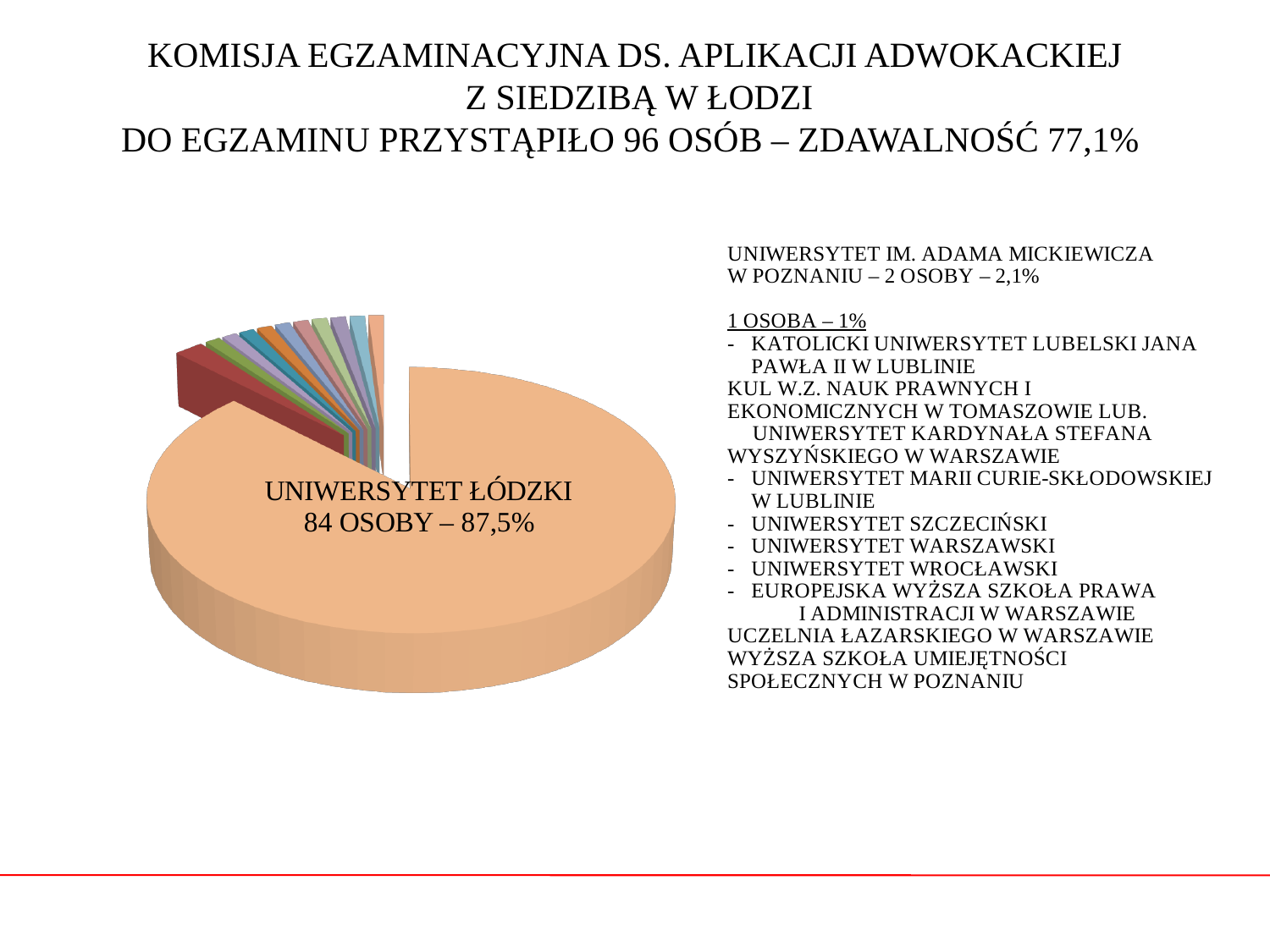
Which university has the largest slice of the pie? Uniwersytet Łódzki What is the difference in percentage points between the share of Uniwersytet Łódzki and that of Uniwersytet im. Adama Mickiewicza w Poznaniu? 85,4 Is the share for Uniwersytet Łódzki greater or less than 50%? greater According to the slide title, how many people took the exam in total? 96 What share is given for Uniwersytet Szczeciński? 1% What kind of chart is shown on the slide? pie chart What share of the pie does Uniwersytet Łódzki account for? 87,5% Which has the larger share: Uniwersytet Łódzki or Uniwersytet im. Adama Mickiewicza w Poznaniu? Uniwersytet Łódzki What share is given for Uniwersytet im. Adama Mickiewicza w Poznaniu? 2,1% How many people from Uniwersytet Łódzki took the exam according to the chart label? 84 How many more people came from Uniwersytet Łódzki than from Uniwersytet im. Adama Mickiewicza w Poznaniu? 82 How many people from Uniwersytet im. Adama Mickiewicza w Poznaniu took the exam? 2